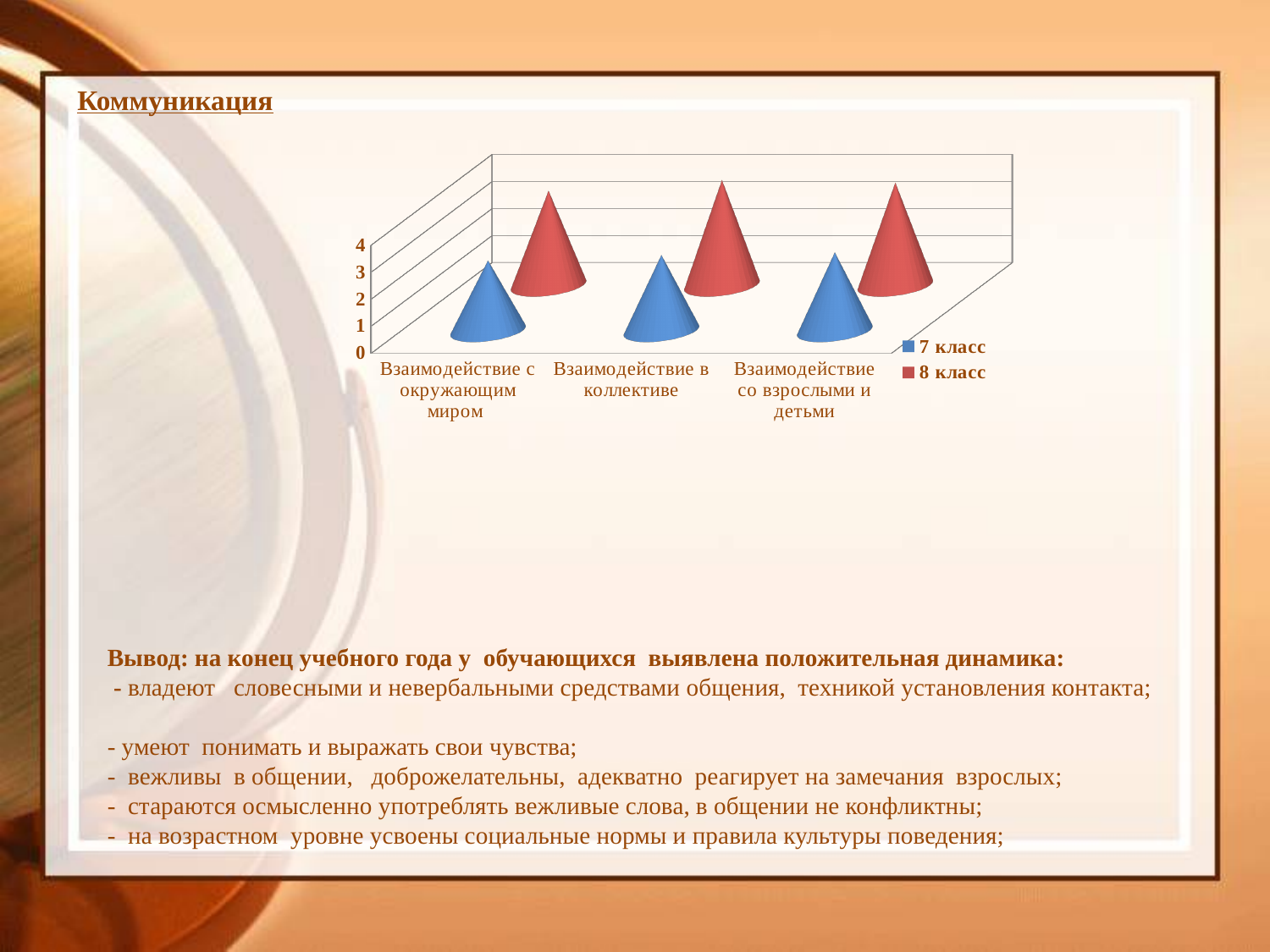
Which colour represents the series "7 класс" in the chart? blue How many categories are shown on the x axis of the chart? 3 Which series is larger for "Взаимодействие с окружающим миром": 7 класс or 8 класс? 8 класс What is the highest tick value shown on the vertical axis of the chart? 4 Which series is larger for "Взаимодействие в коллективе": 7 класс or 8 класс? 8 класс What kind of chart is shown on the slide? bar chart Is the value for 7 класс in "Взаимодействие в коллективе" greater or less than 1? greater Which series is larger for "Взаимодействие со взрослыми и детьми": 7 класс or 8 класс? 8 класс How many series does the chart legend list? 2 Which colour represents the series "8 класс" in the chart? red Is the value for 8 класс in "Взаимодействие со взрослыми и детьми" greater or less than 1? greater